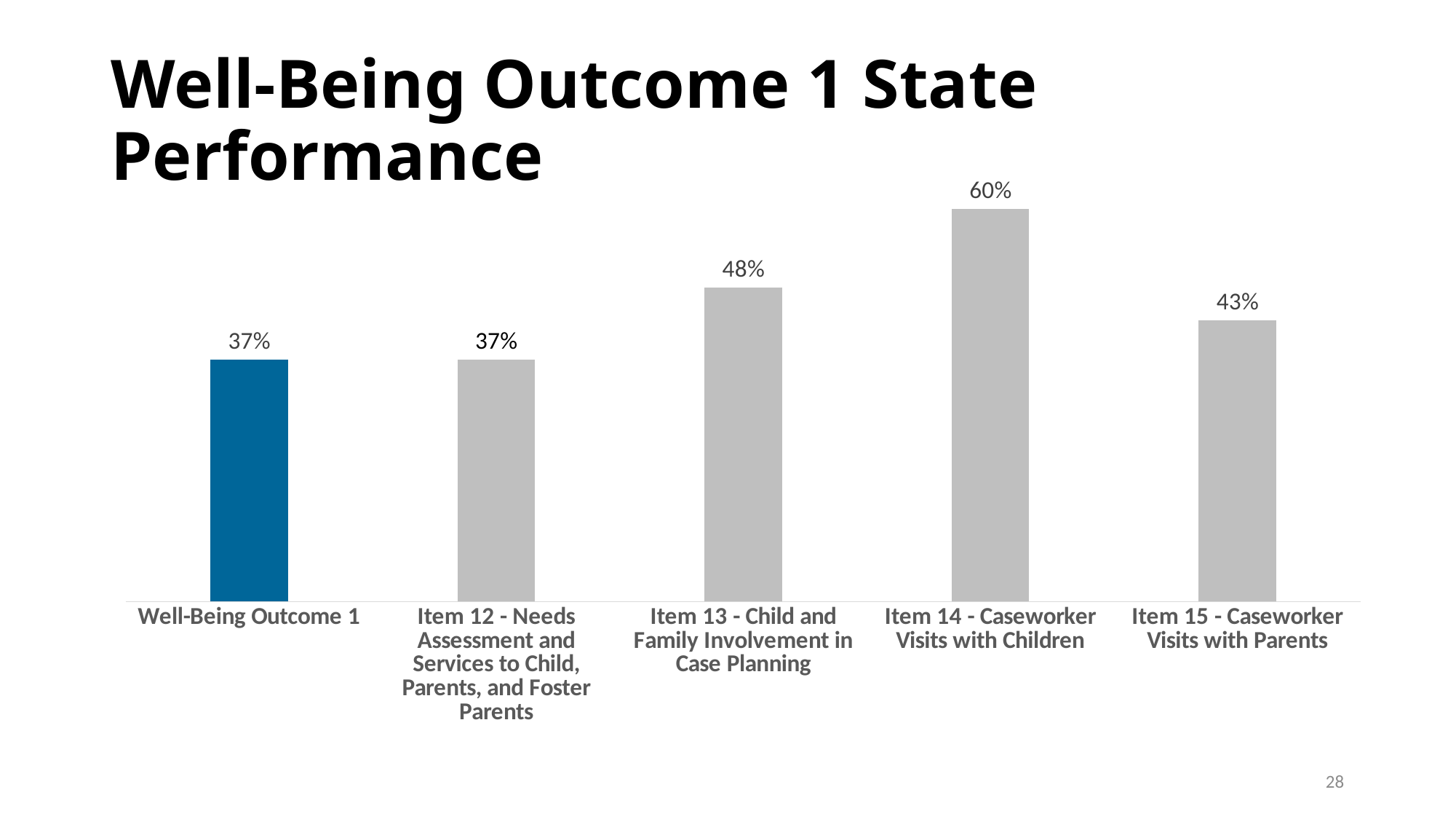
What is the difference between the values for Item 14 - Caseworker Visits with Children and Item 15 - Caseworker Visits with Parents? 17% Which category has the highest value? Item 14 - Caseworker Visits with Children Which bar is coloured blue rather than grey? Well-Being Outcome 1 What is the difference between the values for Item 13 - Child and Family Involvement in Case Planning and Well-Being Outcome 1? 11% What is the value for Item 14 - Caseworker Visits with Children? 60% Which is larger, the value for Item 13 - Child and Family Involvement in Case Planning or the value for Item 15 - Caseworker Visits with Parents? Item 13 - Child and Family Involvement in Case Planning What is the title of the slide? Well-Being Outcome 1 State Performance What is the value for Item 13 - Child and Family Involvement in Case Planning? 48% What is the value for Item 15 - Caseworker Visits with Parents? 43% What is the value for Well-Being Outcome 1? 37% How many categories are shown in the chart? 5 What kind of chart is shown on the slide? Bar chart